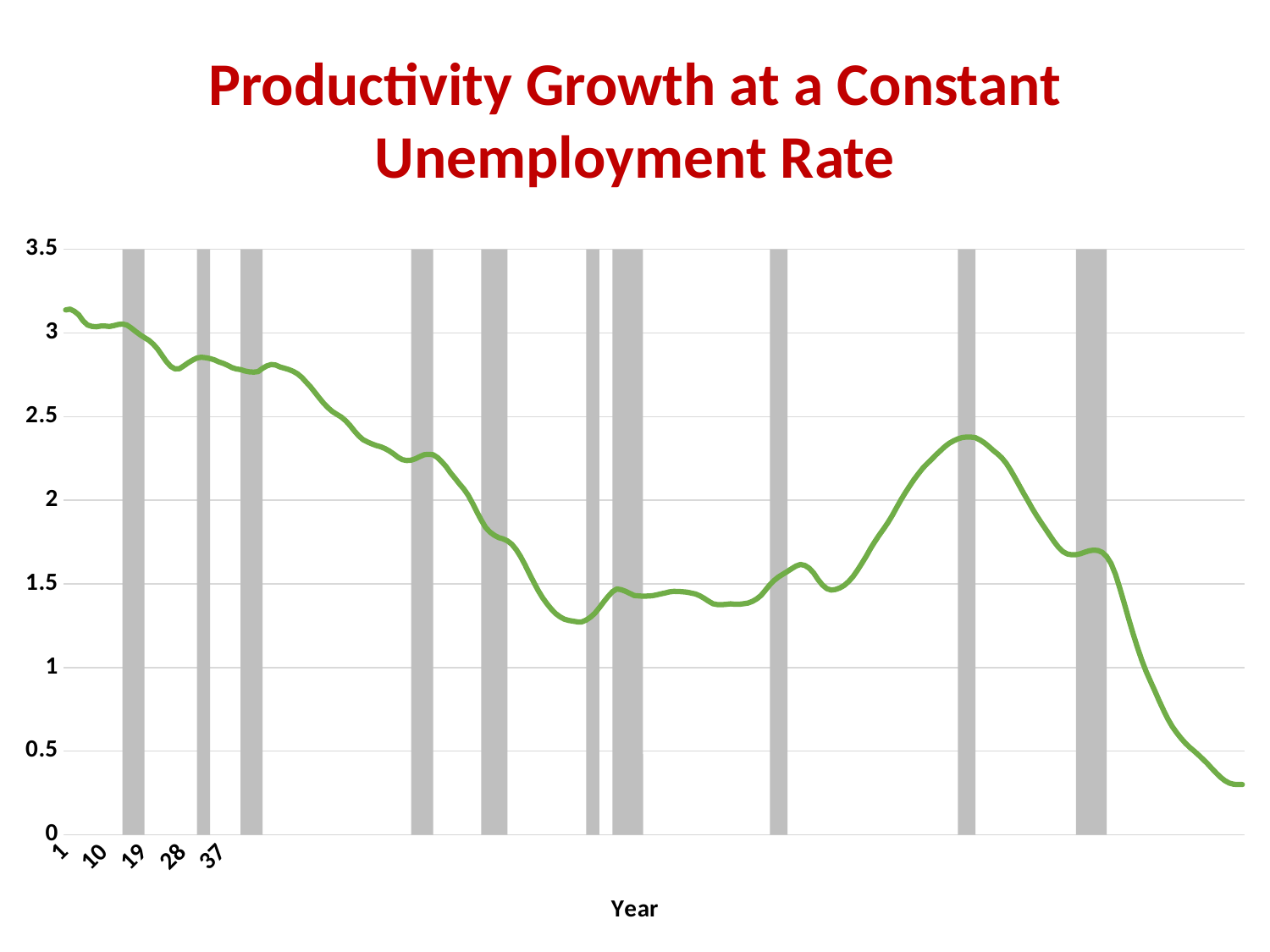
What is the highest value shown on the y axis? 3.5 Overall, does the line rise or fall from the left end of the x axis to the right end? fall Is the value at year 37 greater or less than 2.5? greater What is the label on the x axis of the chart? Year What kind of chart is shown on the slide? line chart Is the value at year 1 greater or less than 3? greater Is the lowest point of the line greater or less than 0.5? less What is the title of the chart? Productivity Growth at a Constant Unemployment Rate Which is larger, the value at year 1 or the value at the right end of the line? year 1